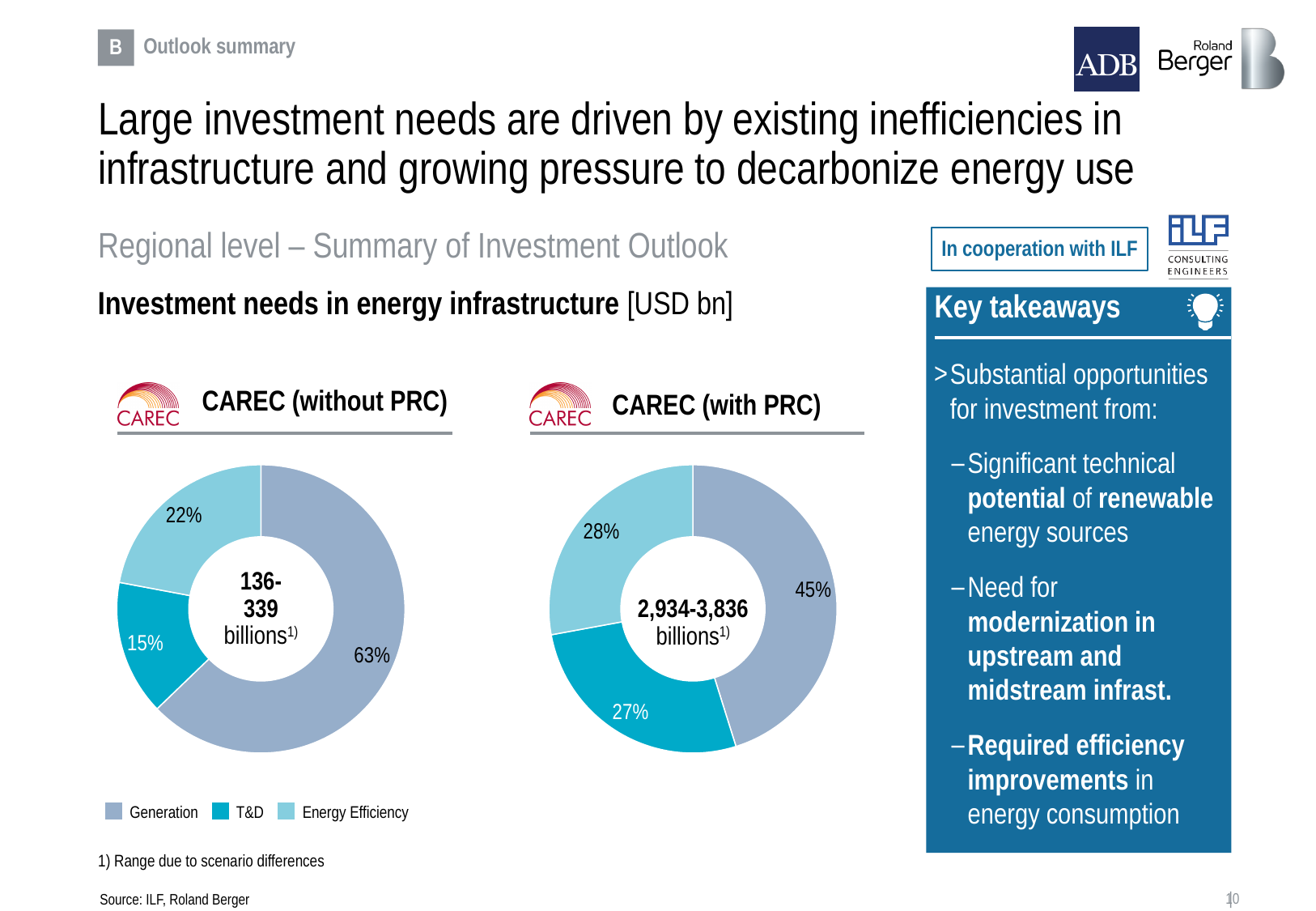
How many categories are shown in each donut chart? 3 Which chart shows a larger share for T&D, CAREC (without PRC) or CAREC (with PRC)? CAREC (with PRC) In the CAREC (without PRC) chart, what share does Generation account for? 63% In the CAREC (with PRC) chart, which category has the largest share? Generation What total investment range is shown in the centre of the CAREC (with PRC) chart? 2,934-3,836 billions How many entries does the legend list? 3 In the CAREC (with PRC) chart, what share does Energy Efficiency account for? 28% In the CAREC (with PRC) chart, what share does T&D account for? 27% What type of chart is used for CAREC (without PRC)? Donut (pie) chart In the CAREC (without PRC) chart, what is the difference between the Generation share and the Energy Efficiency share? 41% In the CAREC (without PRC) chart, which category has the smallest share? T&D In the CAREC (with PRC) chart, what is the difference between the Generation share and the T&D share? 18%